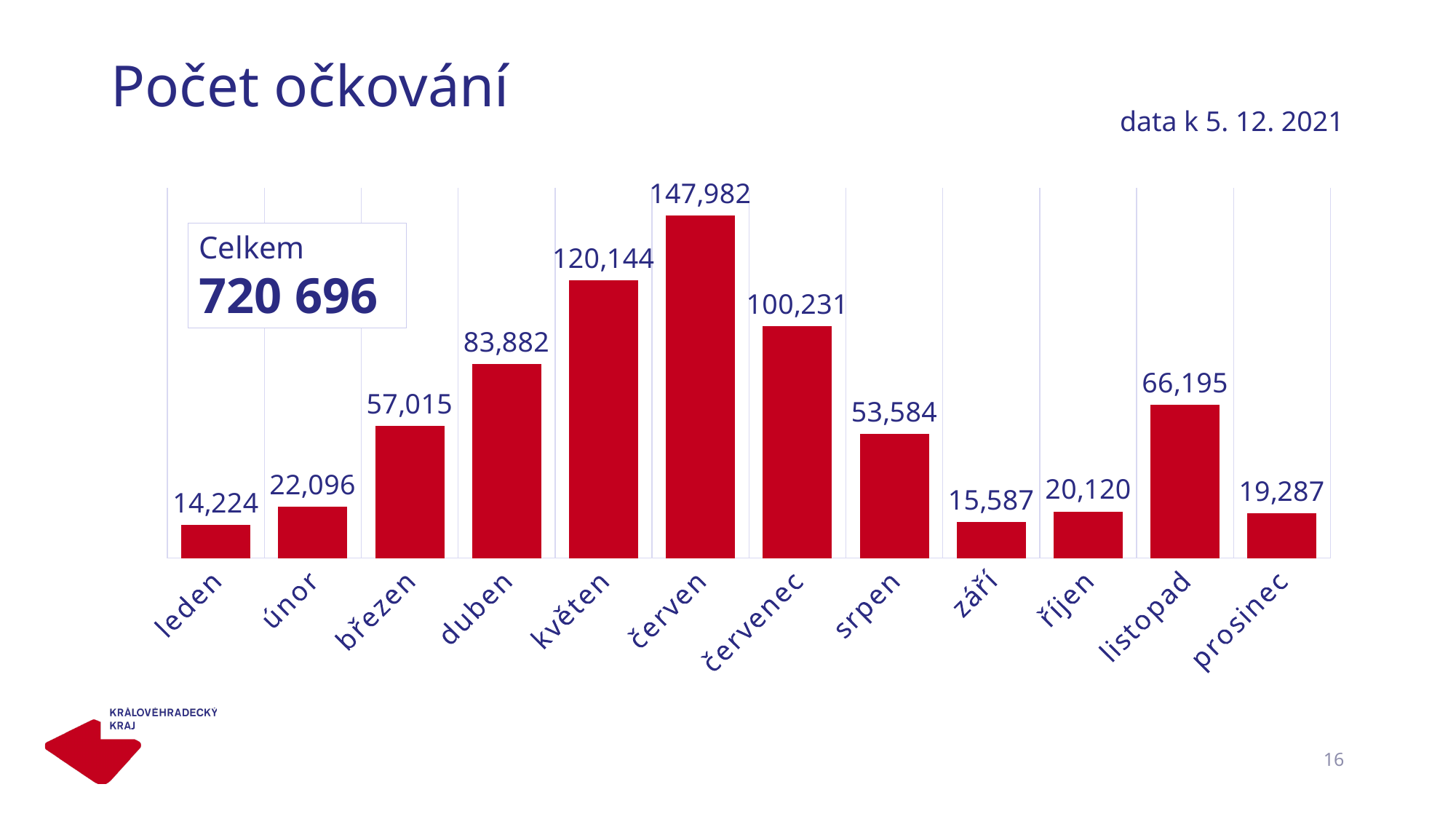
Do the values rise or fall from leden to červen? rise What kind of chart is shown on the slide? bar chart Which month has the highest value? červen Which month has the lowest value? leden What total (Celkem) is shown in the box on the chart? 720 696 What is the value for červen? 147,982 How many months are shown on the x axis? 12 What is the difference between the values for červen and květen? 27,838 What is the value for září? 15,587 What is the value for listopad? 66,195 Which is larger, the value for duben or the value for srpen? duben What is the difference between the values for listopad and říjen? 46,075